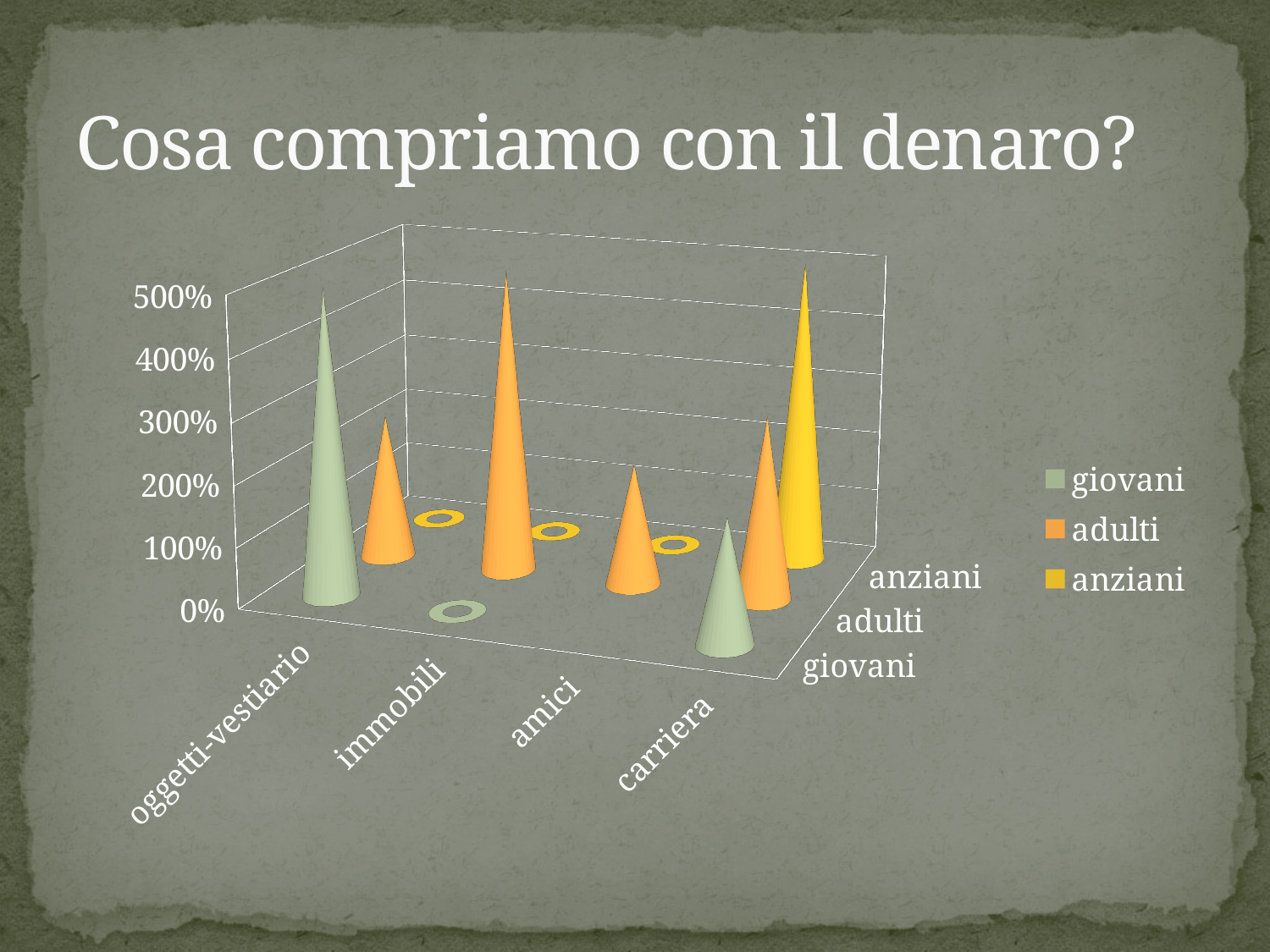
Is the anziani value for carriera greater or less than 300%? greater What is the title of the slide? Cosa compriamo con il denaro? How many series does the legend list? 3 What kind of chart is shown on the slide? bar chart For the adulti series, which category has the highest value? immobili Which series is shown in yellow in the legend? anziani How many categories are shown on the x axis? 4 For the giovani series, which category has the highest value? oggetti-vestiario Is the giovani value for oggetti-vestiario greater or less than 300%? greater For the adulti series, which is larger: the value for immobili or the value for amici? immobili Is the adulti value for immobili greater or less than 300%? greater For the anziani series, which category has the highest value? carriera